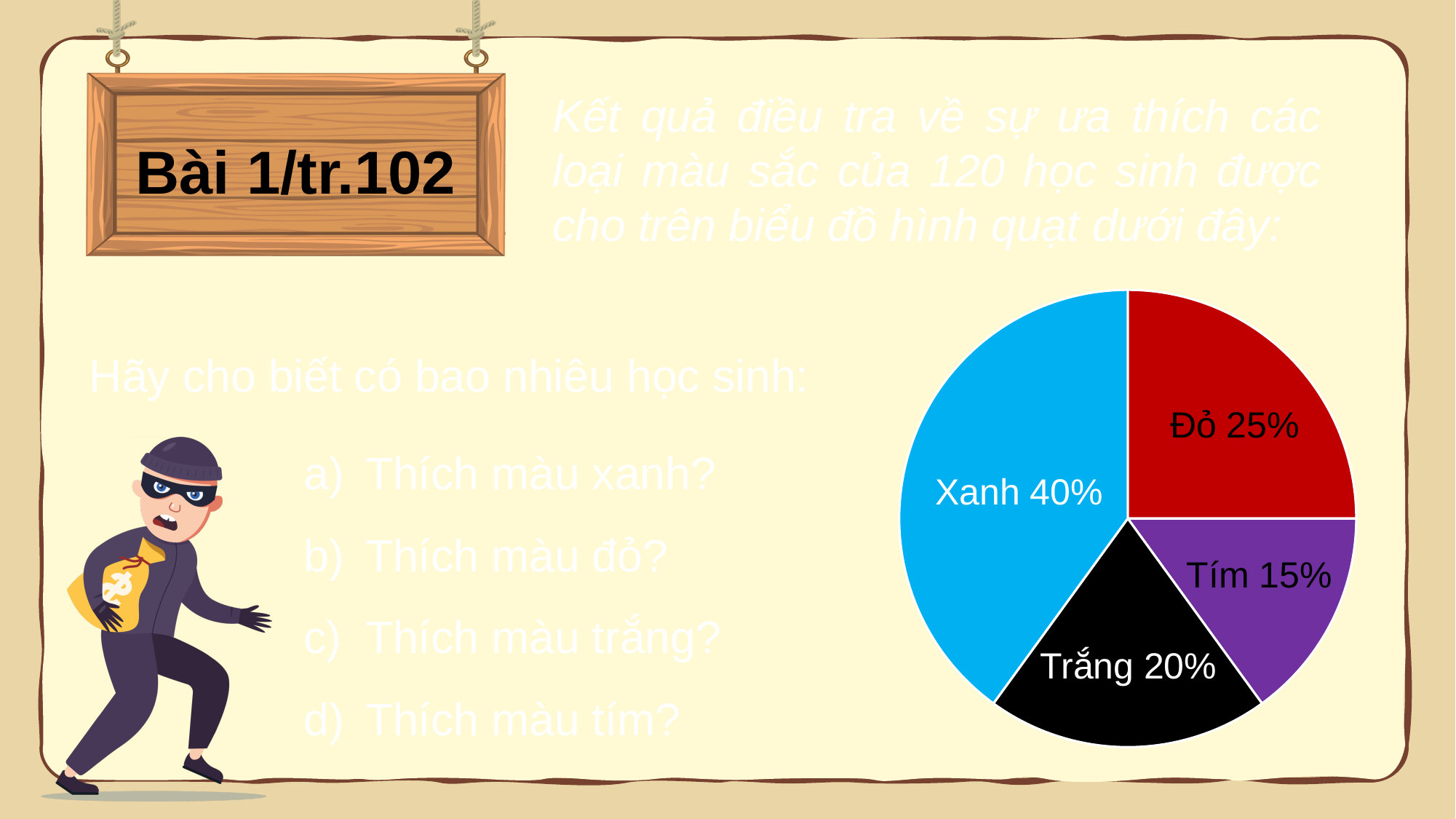
What percentage of the pie chart is labelled Xanh? 40% What percentage of the pie chart is labelled Trắng? 20% What is the combined share of the Đỏ and Tím slices? 40% How many slices does the pie chart have? 4 Which slice of the pie chart is the largest? Xanh What colour is the slice labelled Trắng in the pie chart? black Which slice of the pie chart is the smallest? Tím What is the difference in percentage points between the Xanh slice and the Đỏ slice? 15 What kind of chart is shown on the slide? pie chart What percentage of the pie chart is labelled Đỏ? 25% What percentage of the pie chart is labelled Tím? 15% Which slice is larger, Trắng or Tím? Trắng